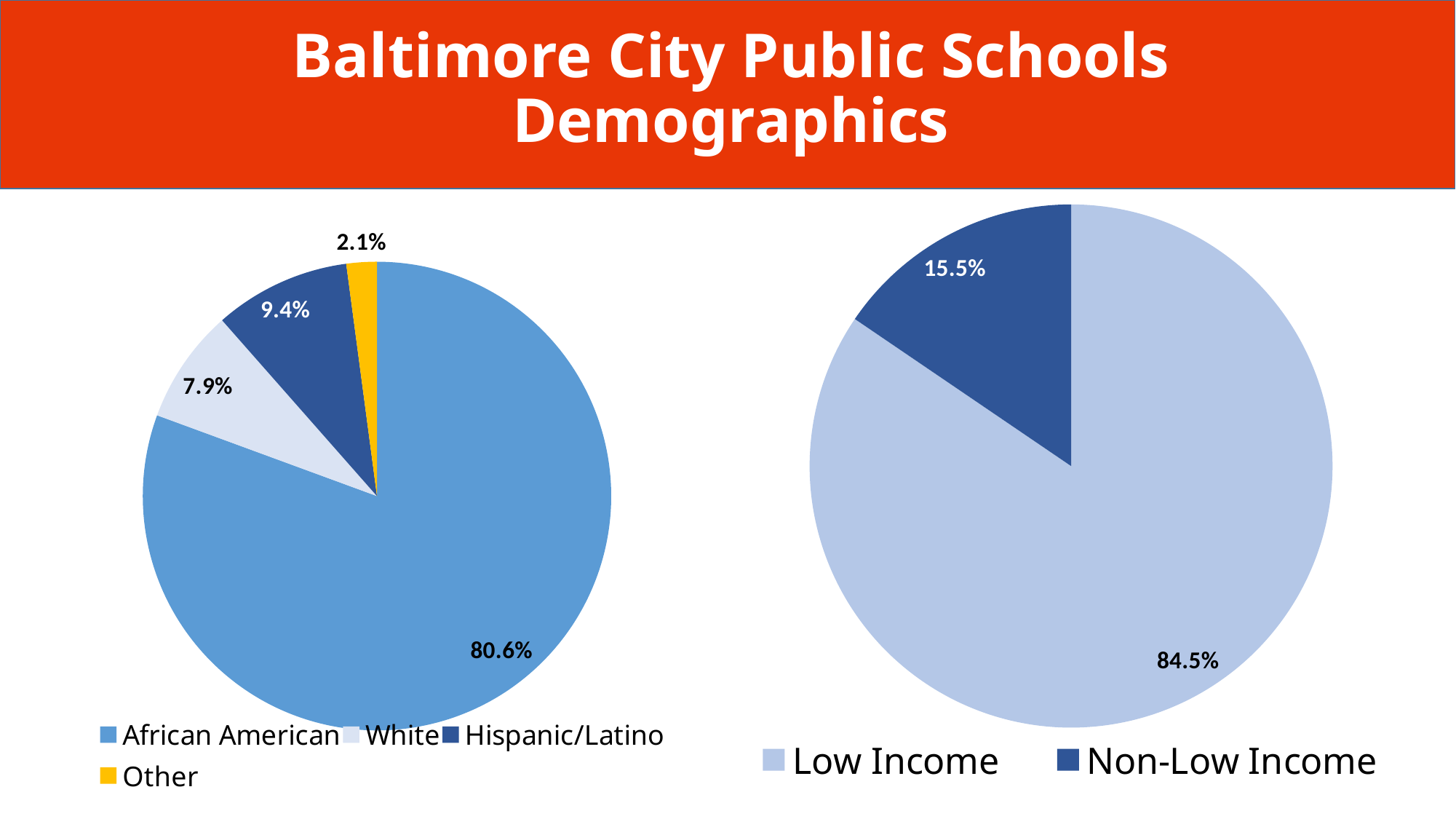
In the right pie chart, what is the difference between the Low Income and Non-Low Income shares? 69.0% In the left pie chart, which category has the largest slice? African American In the left pie chart, which category has the smallest slice? Other In the left pie chart, what share of students is African American? 80.6% In the right pie chart, what share of students is Non-Low Income? 15.5% In the left pie chart, which slice is larger: White or Hispanic/Latino? Hispanic/Latino In the left pie chart, what share of students is labelled Other? 2.1% In the left pie chart, what share of students is White? 7.9% In the right pie chart, what share of students is Low Income? 84.5% How many categories does the legend of the left pie chart list? 4 In the left pie chart, what share of students is Hispanic/Latino? 9.4% What type of chart is shown on the right side of the slide? Pie chart